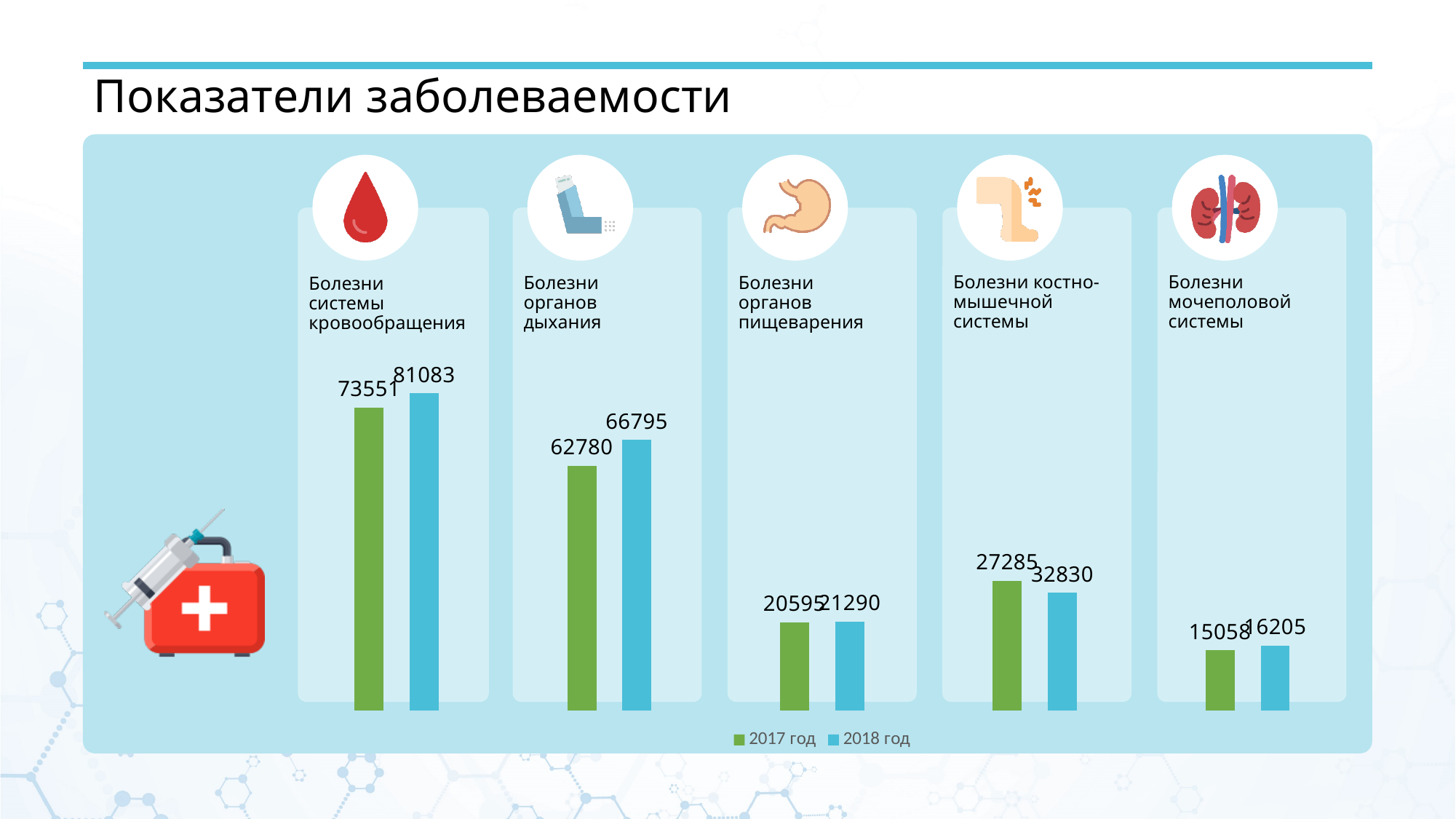
Which category has the highest 2018 год value? Болезни системы кровообращения What is the 2017 год value for Болезни системы кровообращения? 73551 What is the 2018 год value for Болезни костно-мышечной системы? 32830 What type of chart is shown on the slide? Bar chart How many series does the legend list? 2 Which category has the lowest 2017 год value? Болезни мочеполовой системы What is the difference between the 2018 год and 2017 год values for Болезни костно-мышечной системы? 5545 What is the 2017 год value for Болезни мочеполовой системы? 15058 What is the 2018 год value for Болезни органов дыхания? 66795 How many disease categories are shown in the chart? 5 Which is larger: the 2017 год value for Болезни органов пищеварения or the 2017 год value for Болезни костно-мышечной системы? Болезни костно-мышечной системы What is the difference between the 2018 год and 2017 год values for Болезни системы кровообращения? 7532